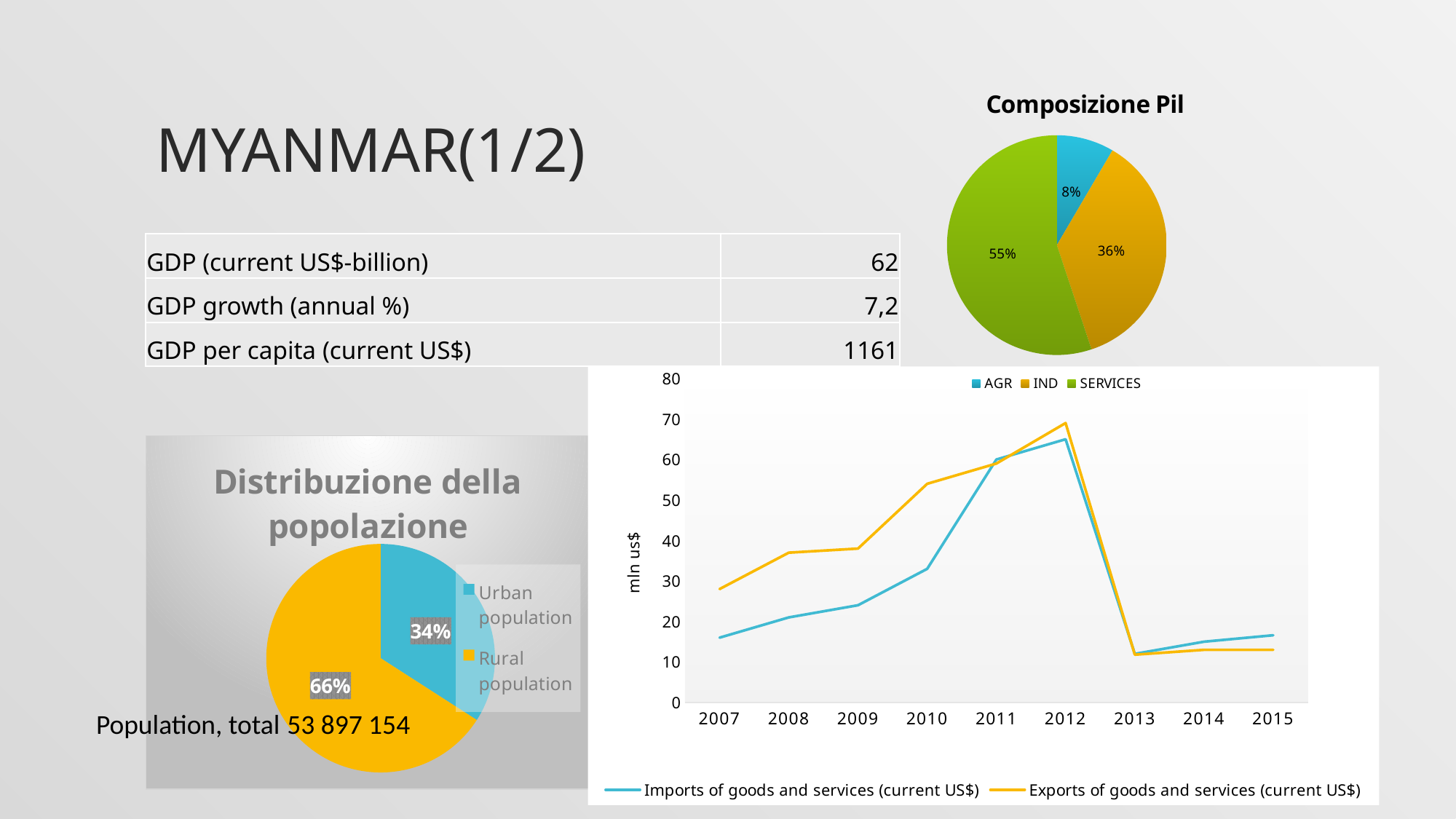
In the 'Composizione Pil' pie chart, what is the difference between the IND share and the AGR share? 28% In the 'Distribuzione della popolazione' pie chart, which is larger, Urban population or Rural population? Rural population In the 'Distribuzione della popolazione' pie chart, what share is the Rural population? 66% In the bottom-right line chart, how many years are shown on the x axis? 9 In the 'Composizione Pil' pie chart, what share does SERVICES have? 55% In the bottom-right line chart, is the value for Exports of goods and services in 2012 greater or less than 60? greater In the 'Composizione Pil' pie chart, which sector has the smallest share? AGR How many series does the legend of the bottom-right line chart list? 2 In the 'Composizione Pil' pie chart, which sector has the largest share? SERVICES In the 'Composizione Pil' pie chart, what share does AGR have? 8% What kind of chart is the chart at the bottom right showing imports and exports from 2007 to 2015? Line chart In the 'Distribuzione della popolazione' pie chart, what is the difference between the Rural and Urban population shares? 32%